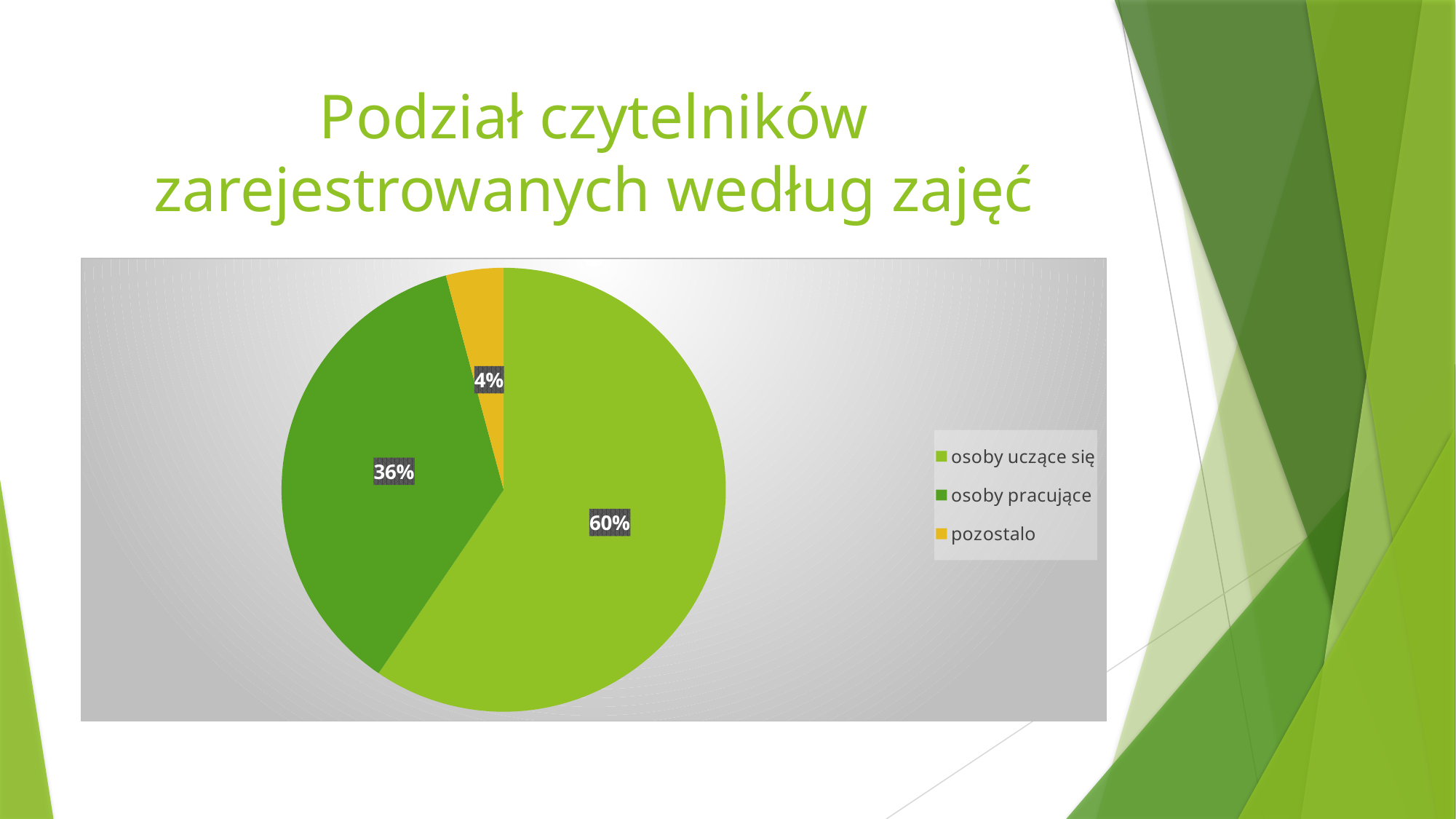
What share of the pie is 'osoby uczące się'? 60% Which category has the smallest slice of the pie? pozostalo What colour is the slice for 'pozostalo'? yellow What is the difference in percentage points between 'osoby pracujące' and 'pozostalo'? 32 What is the difference in percentage points between 'osoby uczące się' and 'osoby pracujące'? 24 What kind of chart is shown on the slide? pie chart What share of the pie is 'osoby pracujące'? 36% Which category has the largest slice of the pie? osoby uczące się How many entries does the legend list? 3 What share of the pie is 'pozostalo'? 4% Which is larger, the slice for 'osoby pracujące' or the slice for 'pozostalo'? osoby pracujące How many slices does the pie chart have? 3